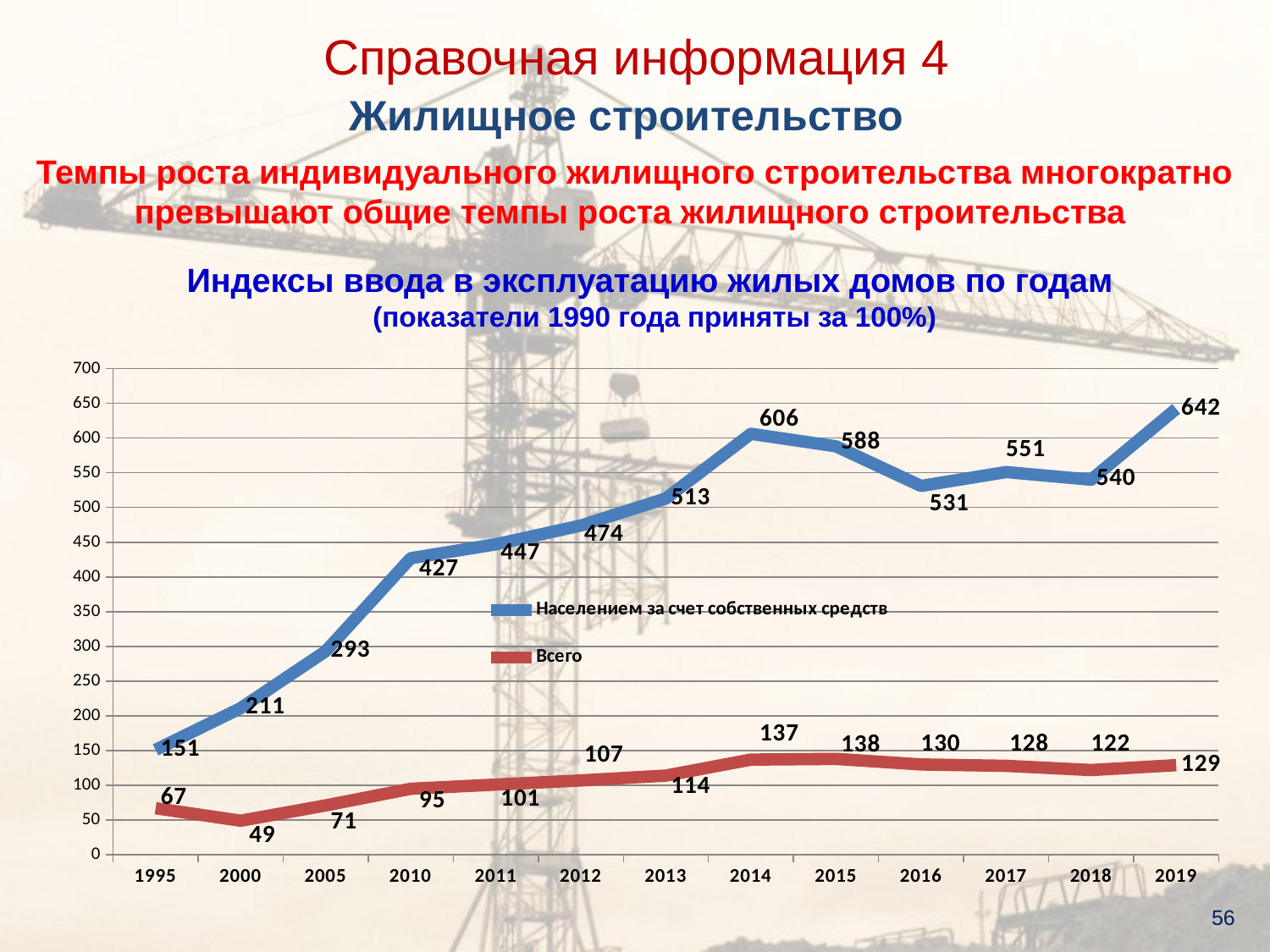
Does the "Всего" series rise or fall between 2000 and 2014? rise In which year is the "Населением за счет собственных средств" series highest? 2019 How many series does the legend list? 2 What is the value for "Всего" in 2000? 49 Which colour is used for the "Всего" series? red How many years are shown on the x axis? 13 What kind of chart is shown on the slide? line chart What is the value for "Населением за счет собственных средств" in 2014? 606 In which year is the "Всего" series lowest? 2000 Which is larger: the "Населением за счет собственных средств" value in 2015 or in 2016? 2015 What is the value for "Всего" in 2019? 129 What is the difference between the "Населением за счет собственных средств" value and the "Всего" value in 2019? 513